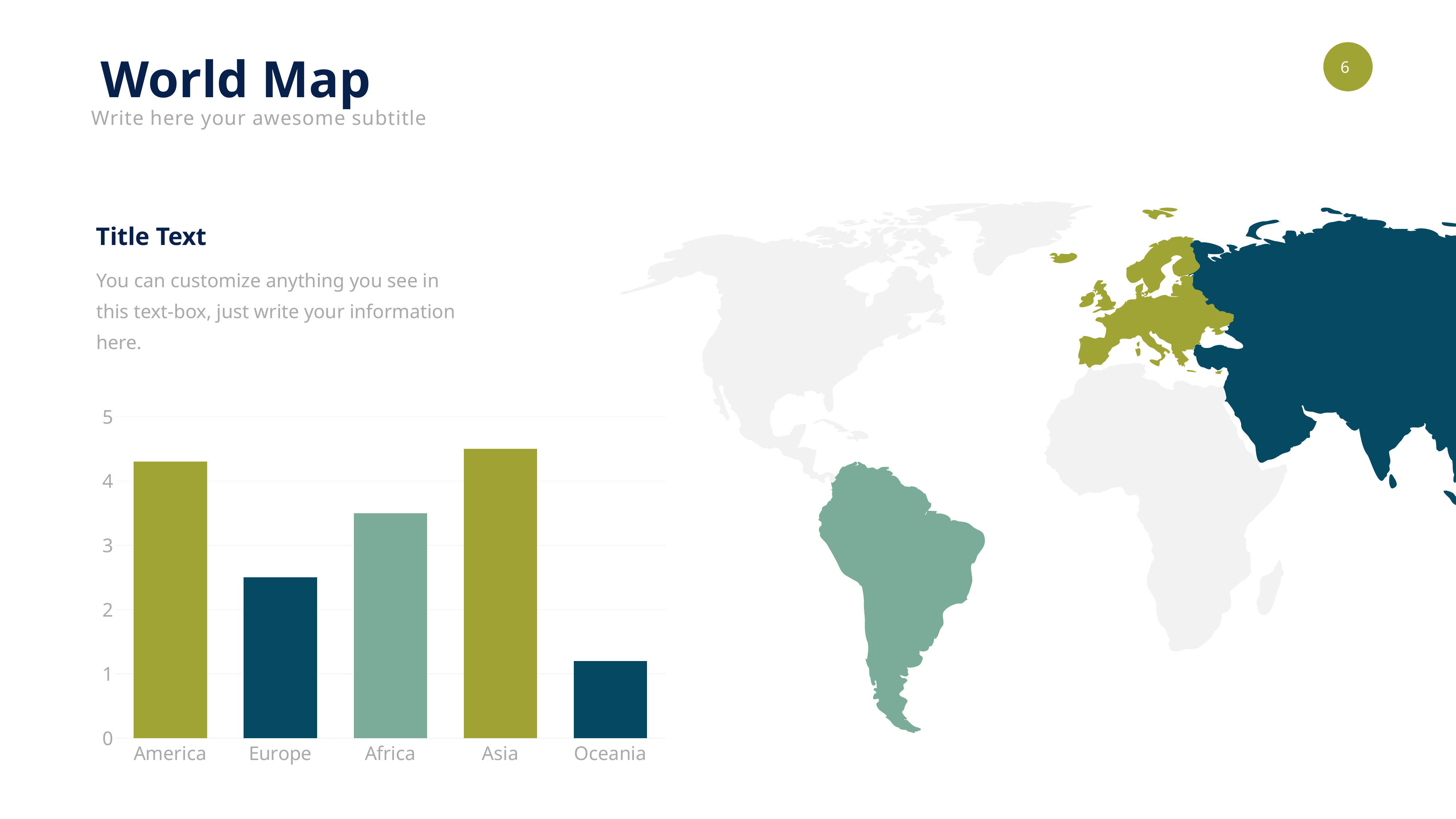
How many categories are shown on the x axis of the bar chart? 5 Is the value for America greater or less than 4? greater Is the value for Oceania greater or less than 2? less Which category has the lowest bar in the chart? Oceania Is the value for Europe greater or less than 3? less Which is larger, the value for Oceania or the value for Europe? Europe Which is larger, the value for Africa or the value for Europe? Africa What is the highest value shown on the chart's vertical axis? 5 Which category has the highest bar in the chart? Asia What kind of chart is shown on the slide? bar chart